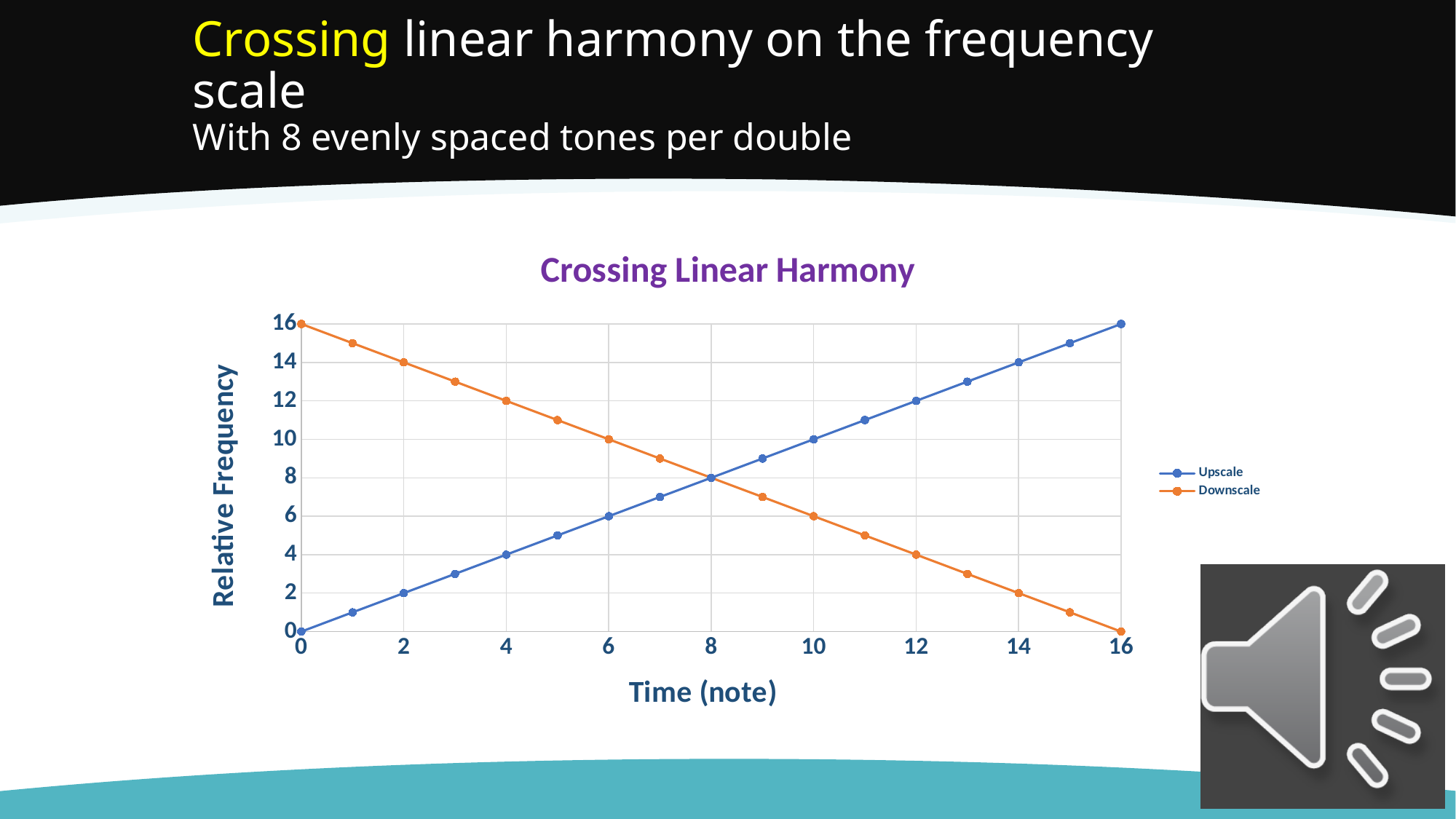
What is the Downscale value at time 0? 16 At time 4, which series has the larger value, Upscale or Downscale? Downscale What is the difference between the Downscale and Upscale values at time 2? 12 How many series does the legend list? 2 What is the Upscale value at time 16? 16 What is the title of the chart? Crossing Linear Harmony What is the Upscale value at time 8? 8 Does the Upscale series rise or fall as time increases? rise What is the Downscale value at time 12? 4 What kind of chart is shown on the slide? line chart Does the Downscale series rise or fall as time increases? fall Is the Upscale value at time 14 greater or less than 10? greater